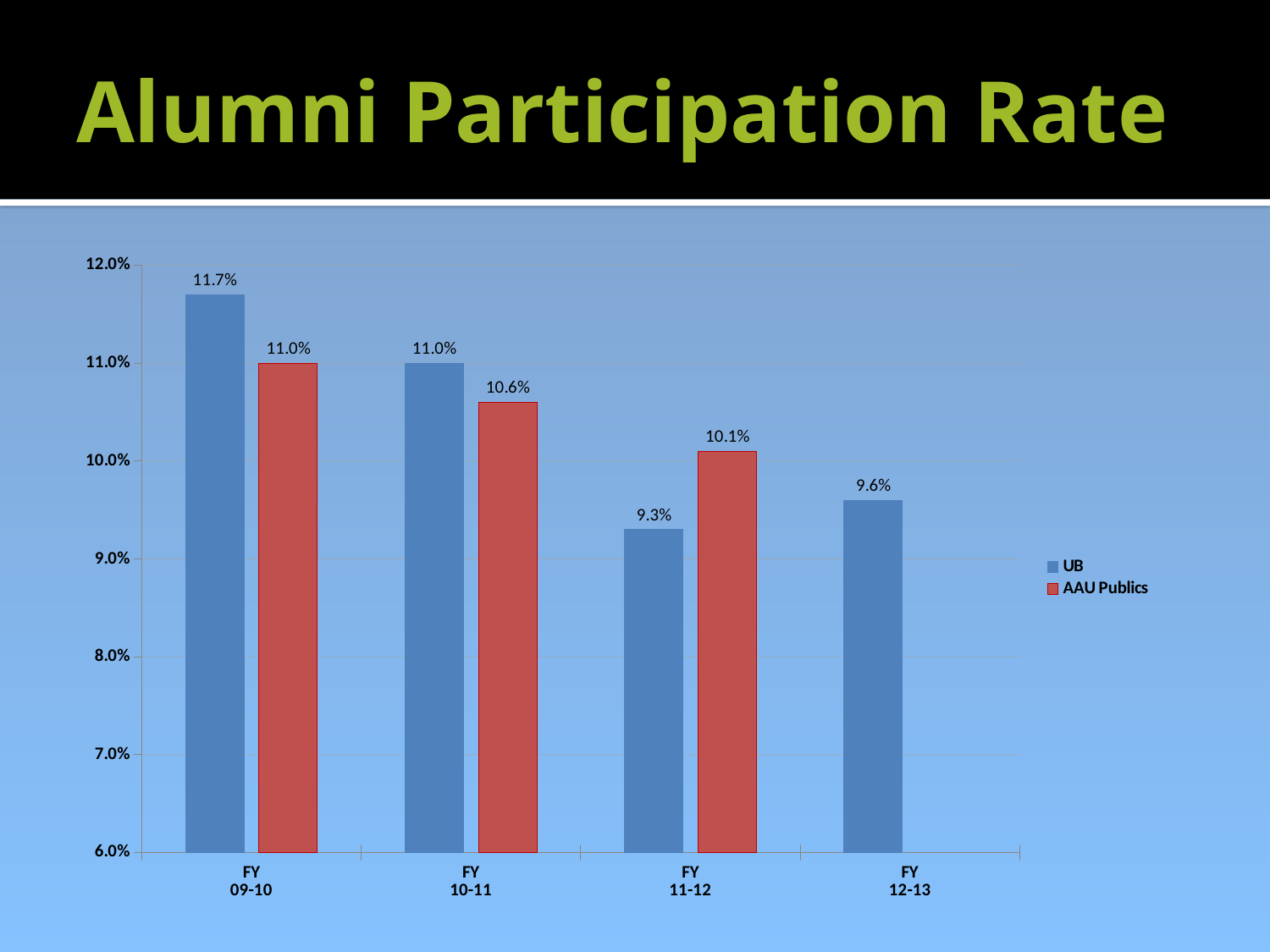
In which fiscal year is the UB alumni participation rate highest? FY 09-10 What is the difference between the UB and AAU Publics rates in FY 09-10? 0.7% Is the UB value for FY 10-11 greater or less than 10.0%? greater Which is larger in FY 11-12, the UB rate or the AAU Publics rate? AAU Publics What is the UB alumni participation rate for FY 12-13? 9.6% Does the AAU Publics rate rise or fall from FY 09-10 to FY 11-12? fall How many fiscal years are shown on the x axis? 4 What is the AAU Publics alumni participation rate for FY 11-12? 10.1% What is the UB alumni participation rate for FY 09-10? 11.7% What kind of chart is shown on the slide? bar chart How many series does the legend list? 2 In which fiscal year is the UB alumni participation rate lowest? FY 11-12